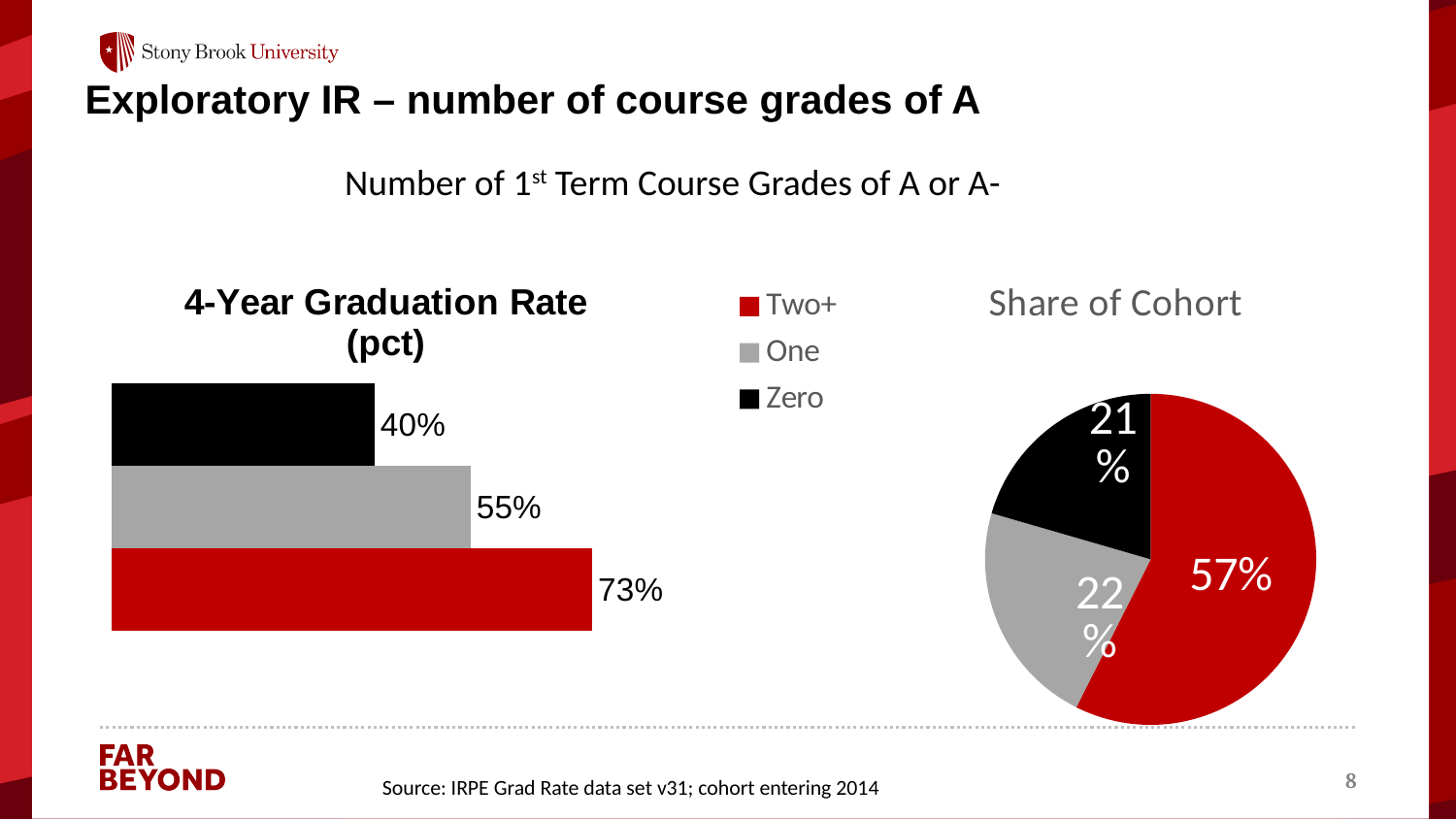
In the 4-Year Graduation Rate (pct) chart, what is the graduation rate for students with One grade of A or A-? 55% In the Share of Cohort pie chart, which category has the smallest slice? Zero In the 4-Year Graduation Rate (pct) chart, what is the graduation rate for students with Two+ grades of A or A-? 73% What kind of chart is the 4-Year Graduation Rate (pct) chart? Bar chart How many entries does the legend list? 3 In the 4-Year Graduation Rate (pct) chart, what is the graduation rate for students with Zero grades of A or A-? 40% In the Share of Cohort pie chart, what share of the cohort had Two+ grades of A or A-? 57% In the 4-Year Graduation Rate (pct) chart, which is larger, the rate for One or the rate for Zero? One In the 4-Year Graduation Rate (pct) chart, which category has the highest graduation rate? Two+ In the 4-Year Graduation Rate (pct) chart, which category has the lowest graduation rate? Zero In the Share of Cohort pie chart, what share of the cohort had One grade of A or A-? 22% In the 4-Year Graduation Rate (pct) chart, what is the difference between the graduation rates for Two+ and Zero? 33%